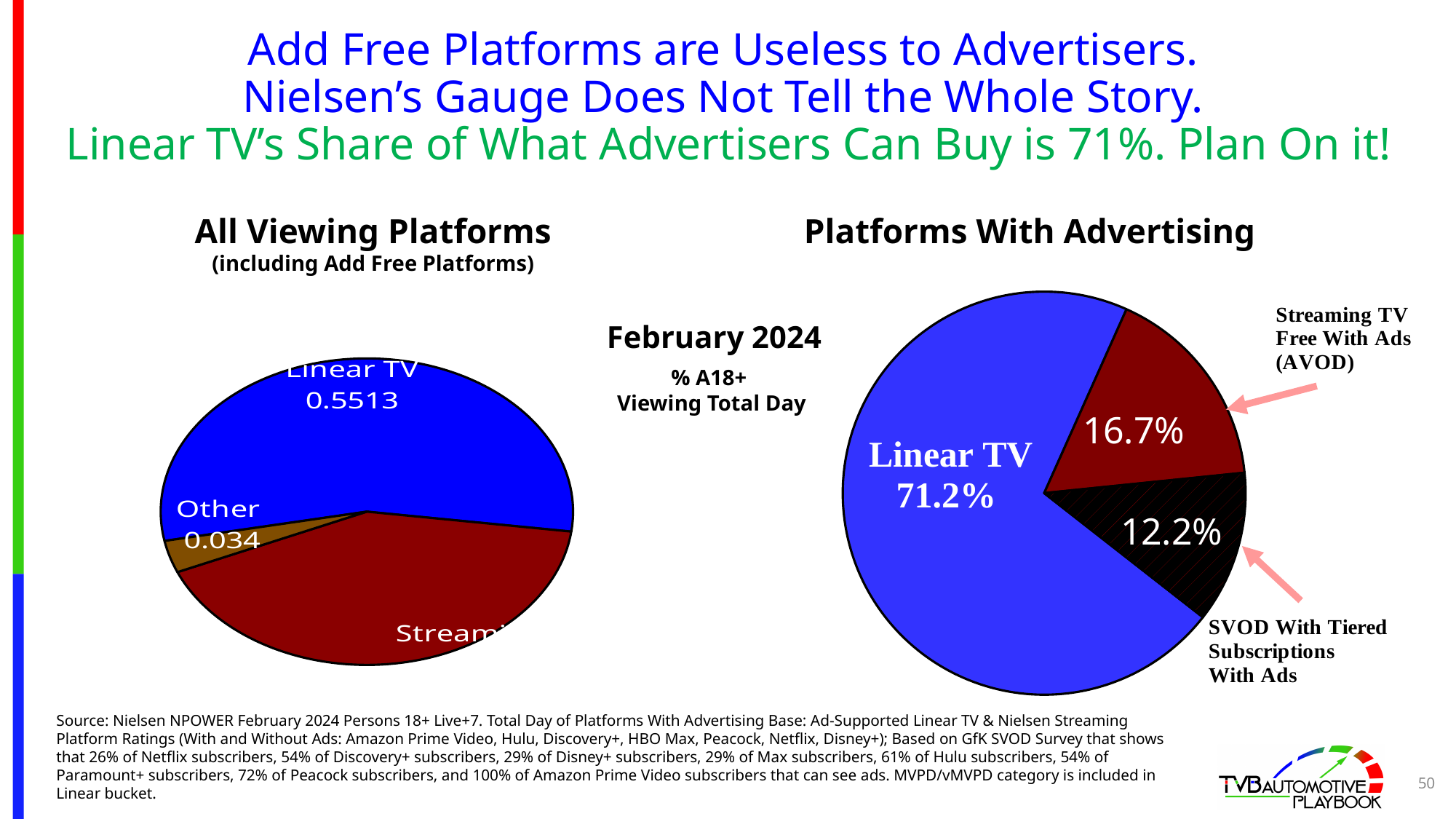
In the 'All Viewing Platforms' pie chart, what is the value shown for Other? 0.034 How many slices does the 'Platforms With Advertising' pie chart have? 3 In the 'All Viewing Platforms' pie chart, which is larger, Linear TV or Other? Linear TV What type of chart is used for 'Platforms With Advertising'? Pie chart In the 'Platforms With Advertising' pie chart, what is the difference between the AVOD share and the SVOD With Tiered Subscriptions With Ads share? 4.5% In the 'Platforms With Advertising' pie chart, what share does Streaming TV Free With Ads (AVOD) have? 16.7% In the 'Platforms With Advertising' pie chart, how many percentage points larger is Linear TV than Streaming TV Free With Ads (AVOD)? 54.5% In the 'Platforms With Advertising' pie chart, which slice is the smallest? SVOD With Tiered Subscriptions With Ads In the 'Platforms With Advertising' pie chart, what share does SVOD With Tiered Subscriptions With Ads have? 12.2% In the 'Platforms With Advertising' pie chart, what share does Linear TV have? 71.2% In the 'All Viewing Platforms' pie chart, what is the value shown for Linear TV? 0.5513 In the 'Platforms With Advertising' pie chart, which slice is the largest? Linear TV